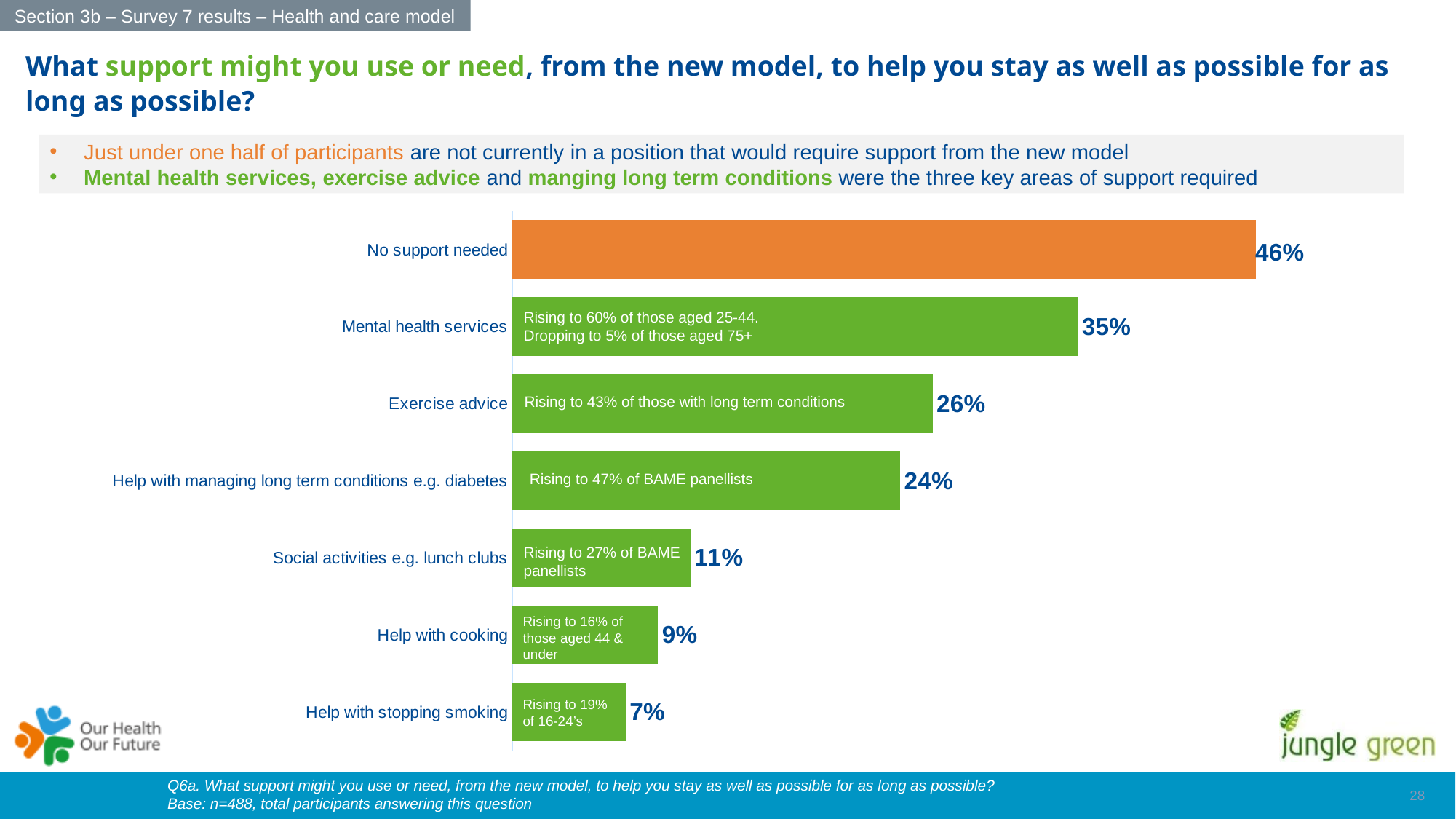
Which category has the lowest value? Help with stopping smoking Which category has the highest value? No support needed What is the value for Help with stopping smoking? 7% Which bar is coloured orange rather than green? No support needed What percentage of participants said no support was needed? 46% What is the difference between Mental health services and Exercise advice? 9% What is the difference between Social activities e.g. lunch clubs and Help with cooking? 2% Which is larger, Exercise advice or Help with managing long term conditions e.g. diabetes? Exercise advice What is the value for Help with managing long term conditions e.g. diabetes? 24% How many categories are shown in the chart? 7 What kind of chart is shown on the slide? Bar chart What is the value for Mental health services? 35%